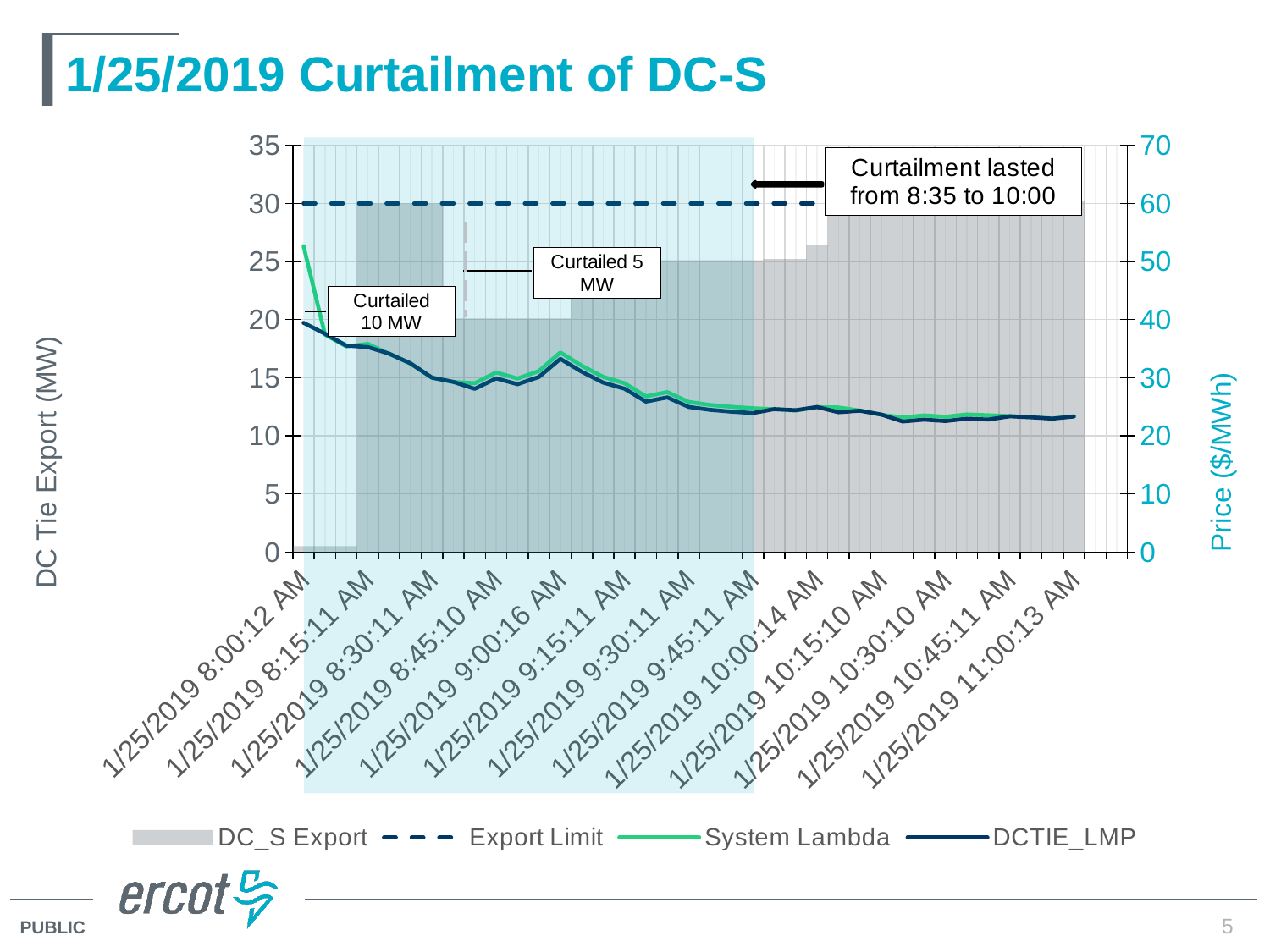
At 1/25/2019 8:00:12 AM, which is higher: System Lambda or DCTIE_LMP? System Lambda How many series does the chart legend list? 4 Does the DCTIE_LMP line generally rise or fall from 8:00 AM to 11:00 AM? fall How many time labels are shown along the x axis? 13 What kind of chart is shown on the slide? Combination bar and line chart Is the System Lambda value at 1/25/2019 8:00:12 AM greater or less than 40 $/MWh? greater What value does the Export Limit line sit at on the left axis? 30 Is the DC_S Export value at 1/25/2019 8:00:12 AM greater or less than 5? less Is the DC_S Export value at 1/25/2019 10:45:11 AM greater or less than 25? greater What is the title of the chart on the slide? 1/25/2019 Curtailment of DC-S According to the annotation on the chart, during what time period did the curtailment last? from 8:35 to 10:00